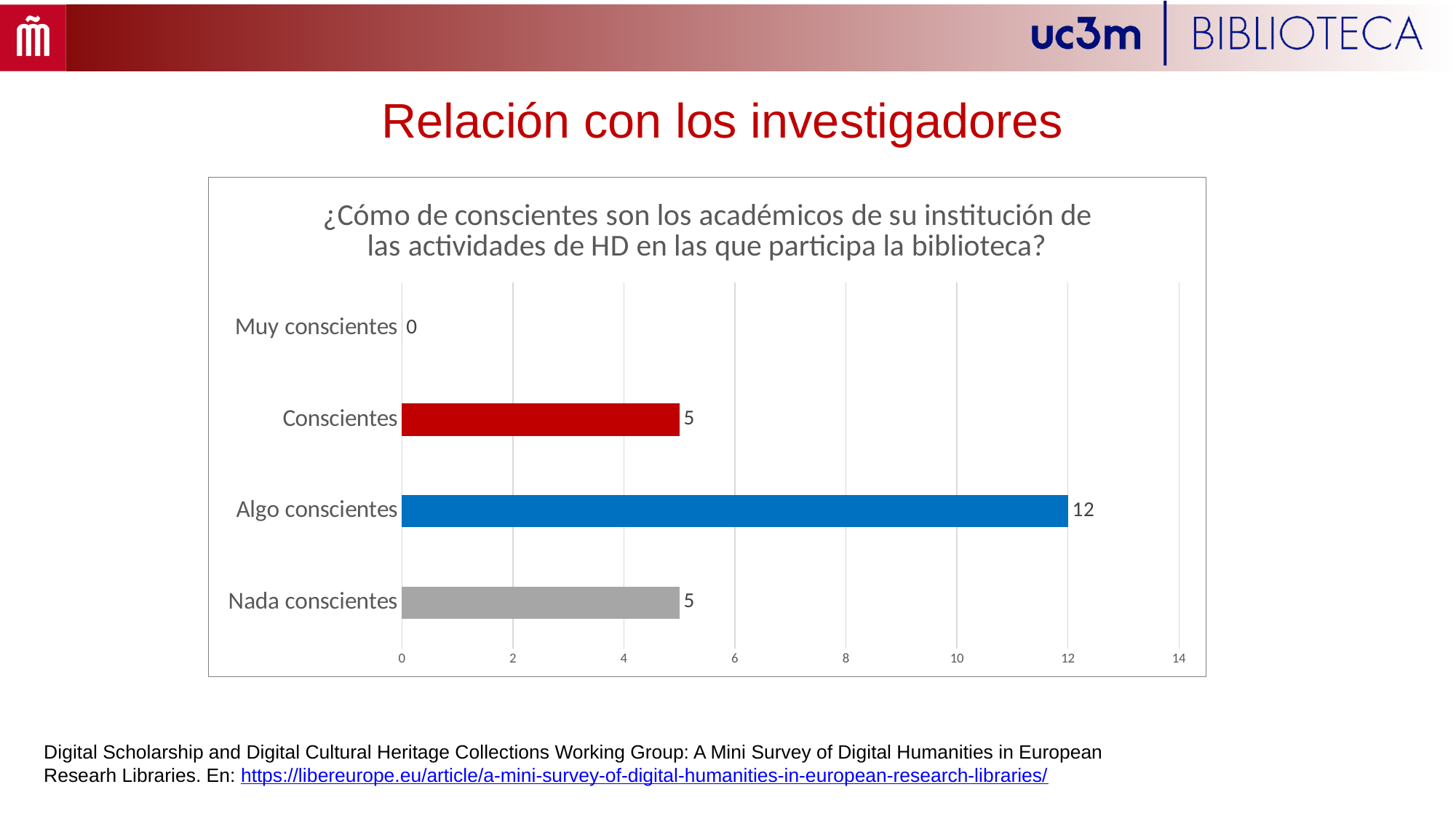
Which category has the lowest value? Muy conscientes What colour is the bar for "Algo conscientes"? blue What is the difference between the values for "Algo conscientes" and "Conscientes"? 7 Which is larger, the value for "Algo conscientes" or the value for "Nada conscientes"? Algo conscientes What is the value for "Algo conscientes"? 12 What is the value for "Conscientes"? 5 What kind of chart is shown on the slide? bar chart Is the value for "Algo conscientes" greater or less than 10? greater How many categories are shown in the chart? 4 What is the value for "Nada conscientes"? 5 What is the value for "Muy conscientes"? 0 Which category has the highest value? Algo conscientes